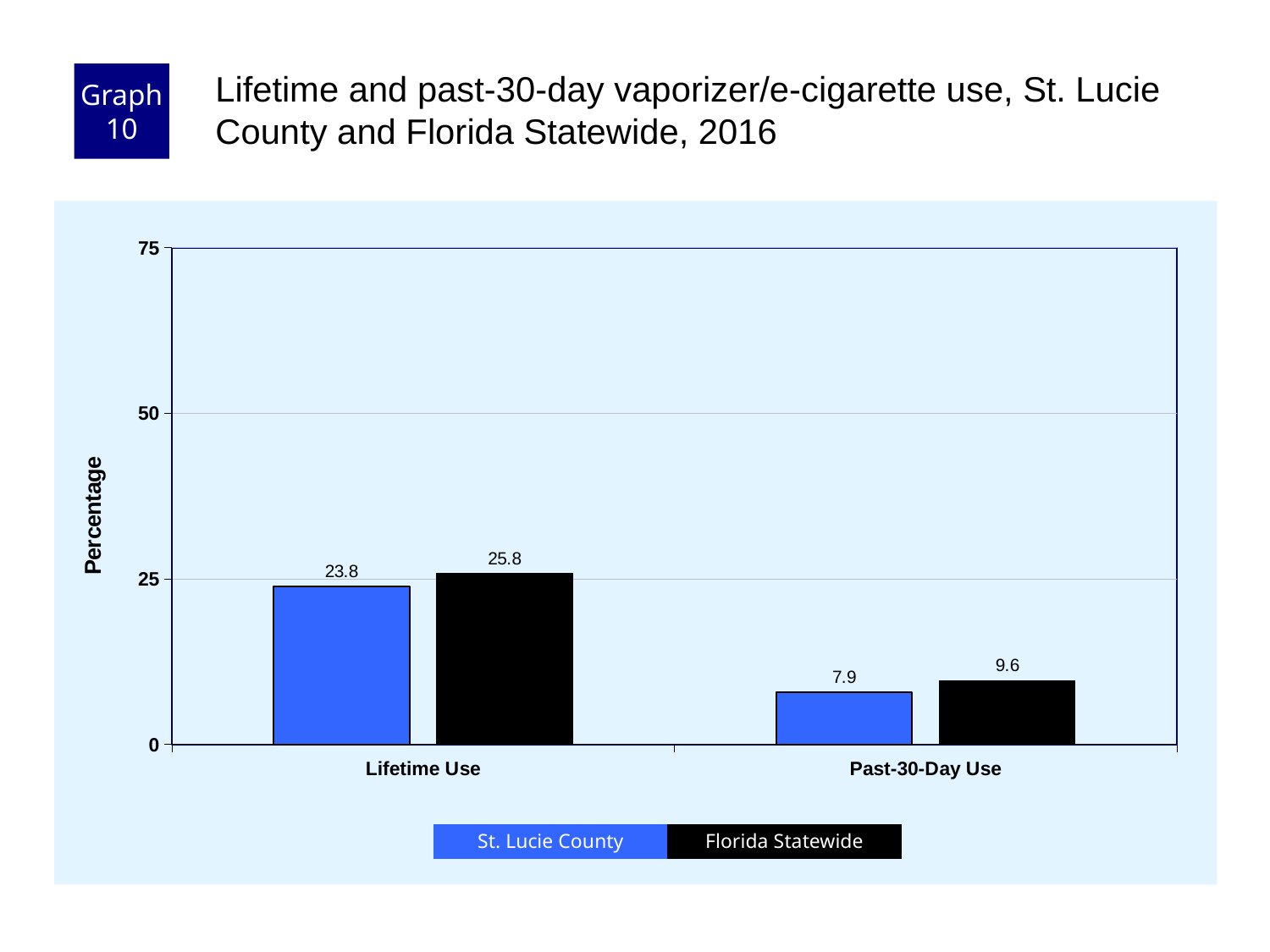
For Past-30-Day Use, which is larger: St. Lucie County or Florida Statewide? Florida Statewide What is the difference between the Florida Statewide and St. Lucie County values for Lifetime Use? 2.0 What kind of chart is shown on the slide? Bar chart What is the St. Lucie County value for Lifetime Use? 23.8 How many categories are shown on the x axis? 2 Which category has the highest Florida Statewide value? Lifetime Use What is the St. Lucie County value for Past-30-Day Use? 7.9 How many series does the legend list? 2 What is the Florida Statewide value for Past-30-Day Use? 9.6 What is the difference between the Florida Statewide and St. Lucie County values for Past-30-Day Use? 1.7 What is the Florida Statewide value for Lifetime Use? 25.8 Which category has the lowest St. Lucie County value? Past-30-Day Use